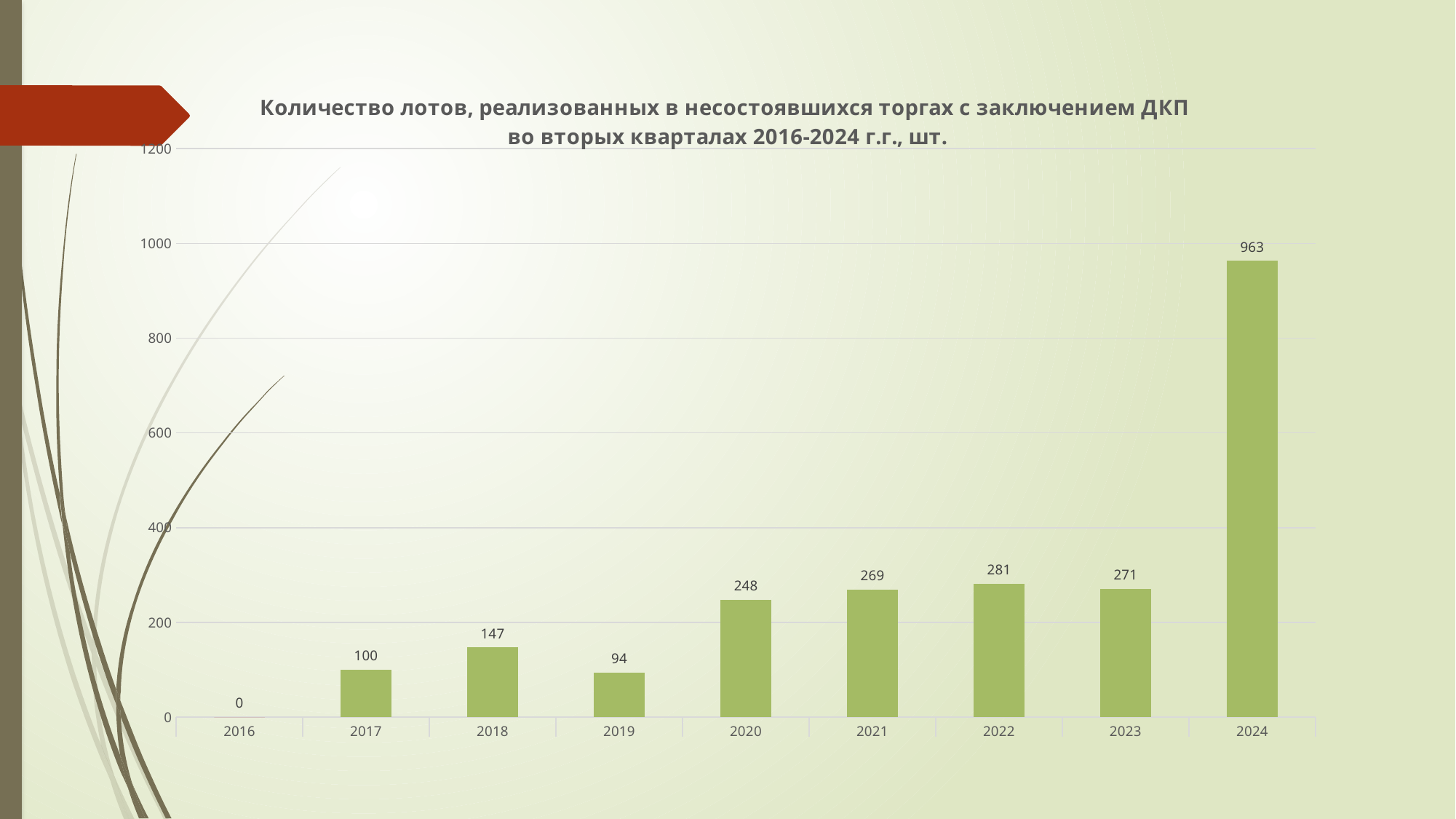
What is the highest value shown on the vertical axis? 1200 Is the value for 2024 greater or less than 800? greater What is the value for 2017? 100 Which is larger, the value for 2022 or the value for 2021? 2022 How many years are shown on the x axis? 9 Which year has the lowest value? 2016 What is the difference between the values for 2024 and 2023? 692 What is the value for 2016? 0 What is the value for 2020? 248 Which year has the highest value? 2024 What kind of chart is shown on the slide? bar chart What is the difference between the values for 2018 and 2019? 53